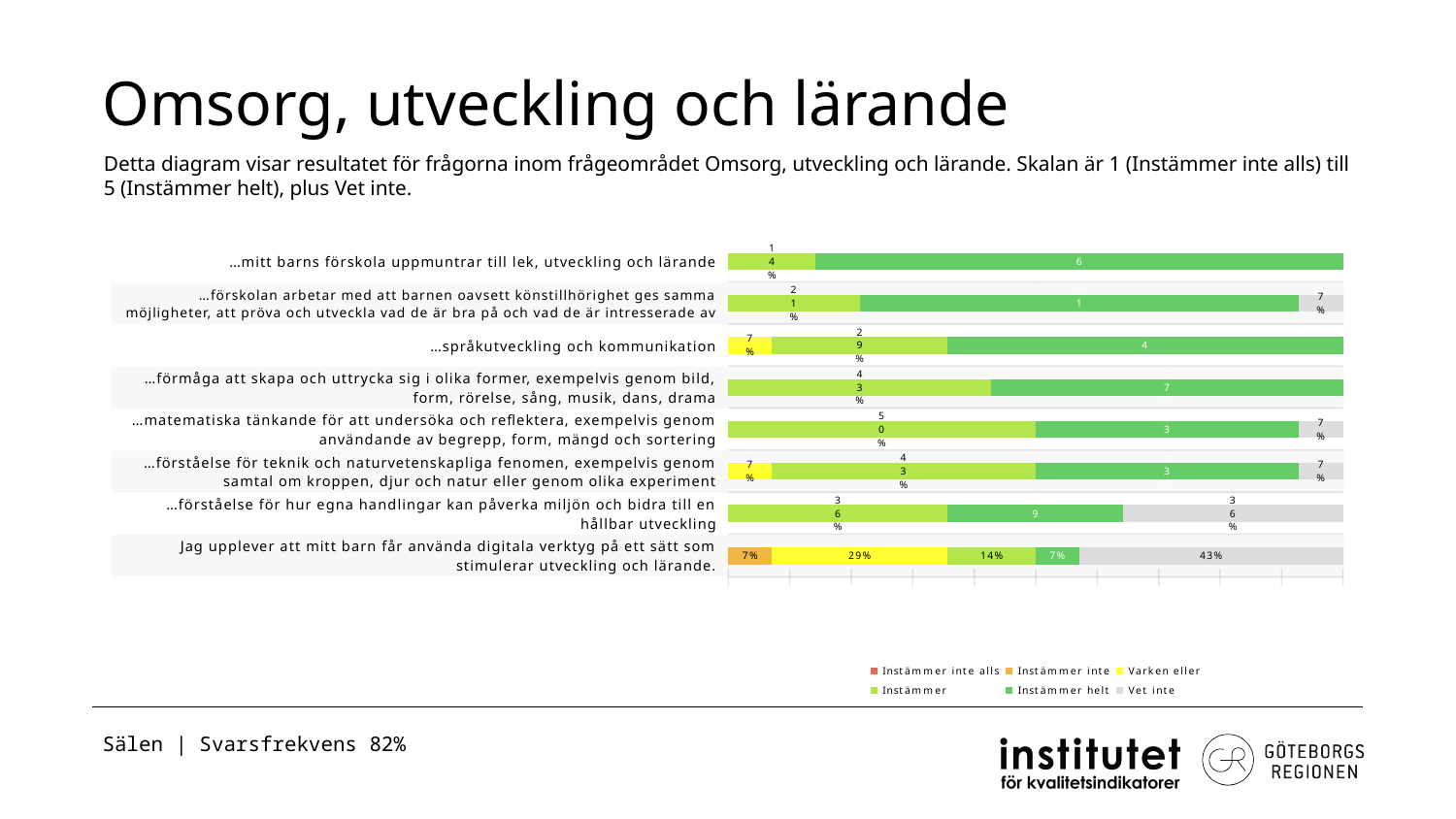
What is the 'Instämmer inte' value for the statement about digitala verktyg? 7% What is the 'Instämmer' value for the statement '…matematiska tänkande för att undersöka och reflektera, exempelvis genom användande av begrepp, form, mängd och sortering'? 50% For the statement about digitala verktyg, which is larger: 'Varken eller' or 'Instämmer'? Varken eller Which response category has the largest share for the statement about digitala verktyg? Vet inte What response rate (Svarsfrekvens) is shown at the bottom of the slide? 82% What kind of chart is shown on the slide? Stacked bar chart How many statements (categories) are plotted in the chart? 8 What is the 'Vet inte' value for the statement '…förståelse för hur egna handlingar kan påverka miljön och bidra till en hållbar utveckling'? 36% What is the 'Vet inte' value for the statement 'Jag upplever att mitt barn får använda digitala verktyg på ett sätt som stimulerar utveckling och lärande.'? 43% How many series does the legend list? 6 What is the 'Varken eller' value for the statement 'Jag upplever att mitt barn får använda digitala verktyg på ett sätt som stimulerar utveckling och lärande.'? 29% For the statement about digitala verktyg, what is the difference between the 'Vet inte' value and the 'Instämmer helt' value? 36%